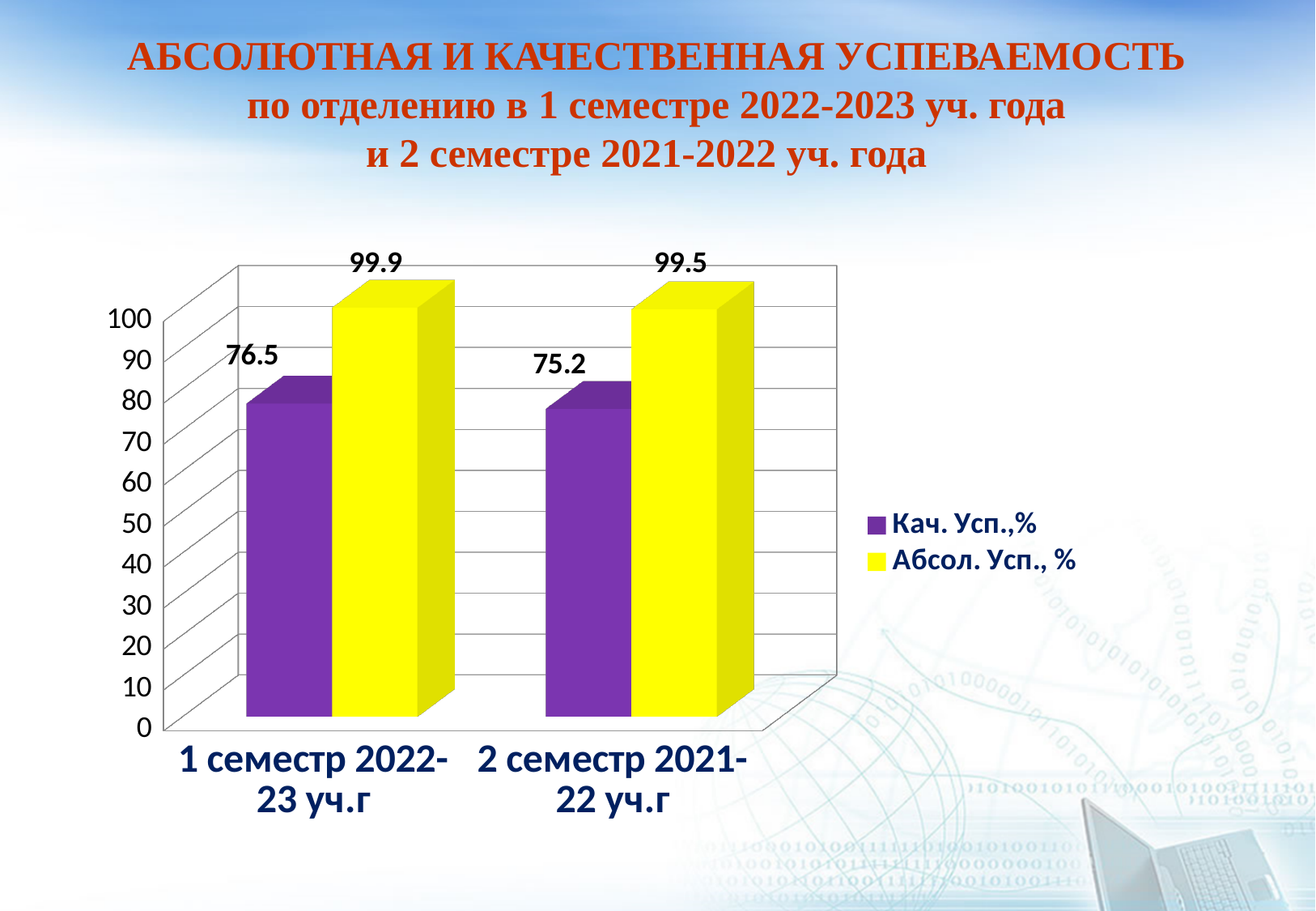
Which category has the lower value for Абсол. Усп., %? 2 семестр 2021-22 уч.г What is the value of Абсол. Усп., % for 1 семестр 2022-23 уч.г? 99.9 What is the difference between Абсол. Усп., % and Кач. Усп.,% for 1 семестр 2022-23 уч.г? 23.4 What is the difference in Кач. Усп.,% between 1 семестр 2022-23 уч.г and 2 семестр 2021-22 уч.г? 1.3 Is the value of Кач. Усп.,% for 2 семестр 2021-22 уч.г greater or less than 80? less Which category has the higher value for Кач. Усп.,%? 1 семестр 2022-23 уч.г What is the value of Абсол. Усп., % for 2 семестр 2021-22 уч.г? 99.5 How many series does the legend list? 2 What is the value of Кач. Усп.,% for 2 семестр 2021-22 уч.г? 75.2 How many categories are shown on the x axis? 2 What is the value of Кач. Усп.,% for 1 семестр 2022-23 уч.г? 76.5 What kind of chart is shown on the slide? bar chart